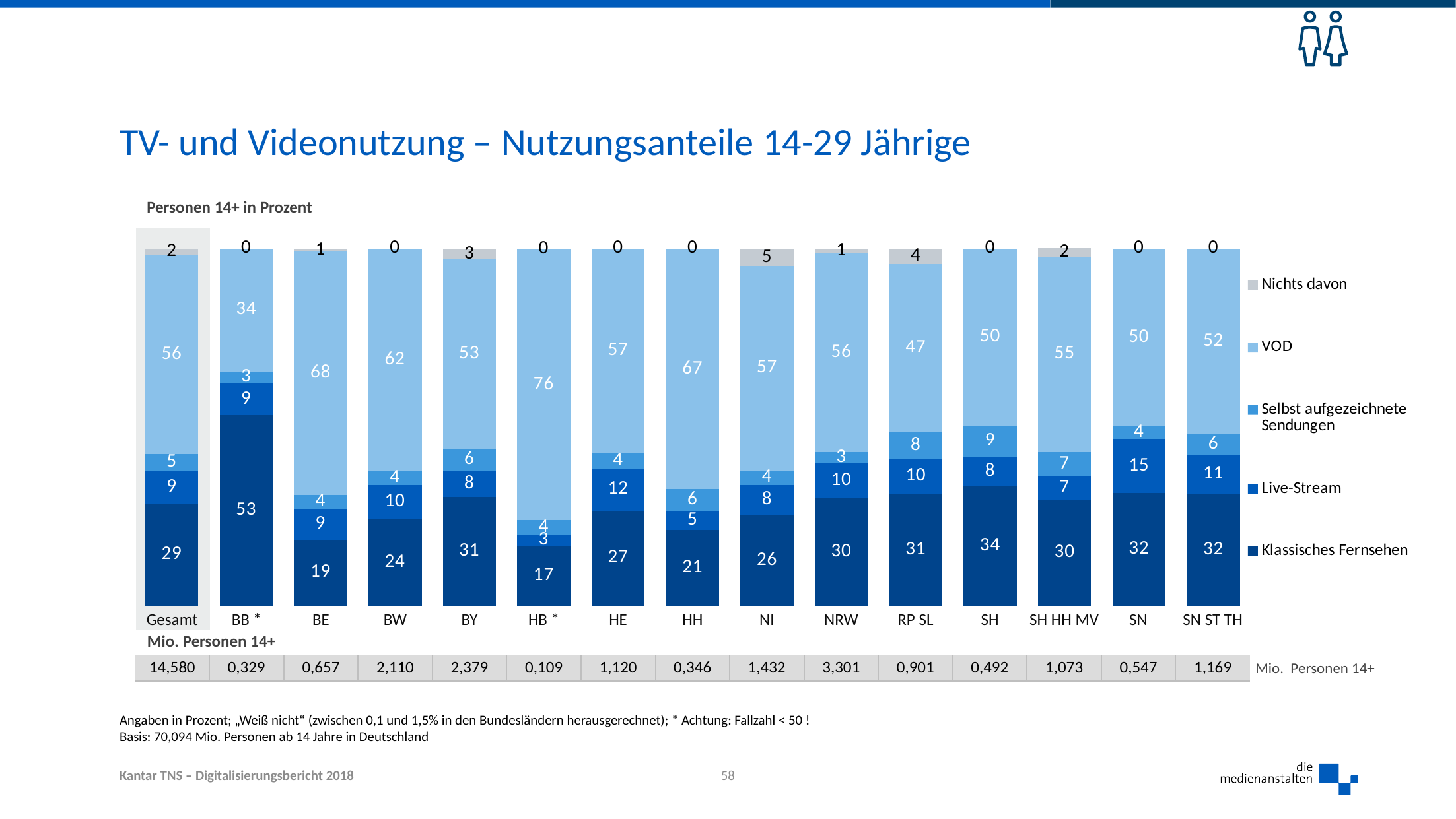
Which category has the lowest Klassisches Fernsehen value? HB * How many series does the legend list? 5 What is the Live-Stream value for SN? 15 Which is larger, the VOD value for BE or the VOD value for BW? BE How many categories (bars) are shown along the x axis? 15 Which legend entry is shown in the lightest grey colour? Nichts davon What type of chart is shown on the slide? stacked bar chart Which category has the highest Klassisches Fernsehen value? BB * What is the Nichts davon value for NI? 5 What is the difference between the VOD values for HB * and BB *? 42 What is the VOD value for HB *? 76 What is the value for Klassisches Fernsehen in the Gesamt bar? 29